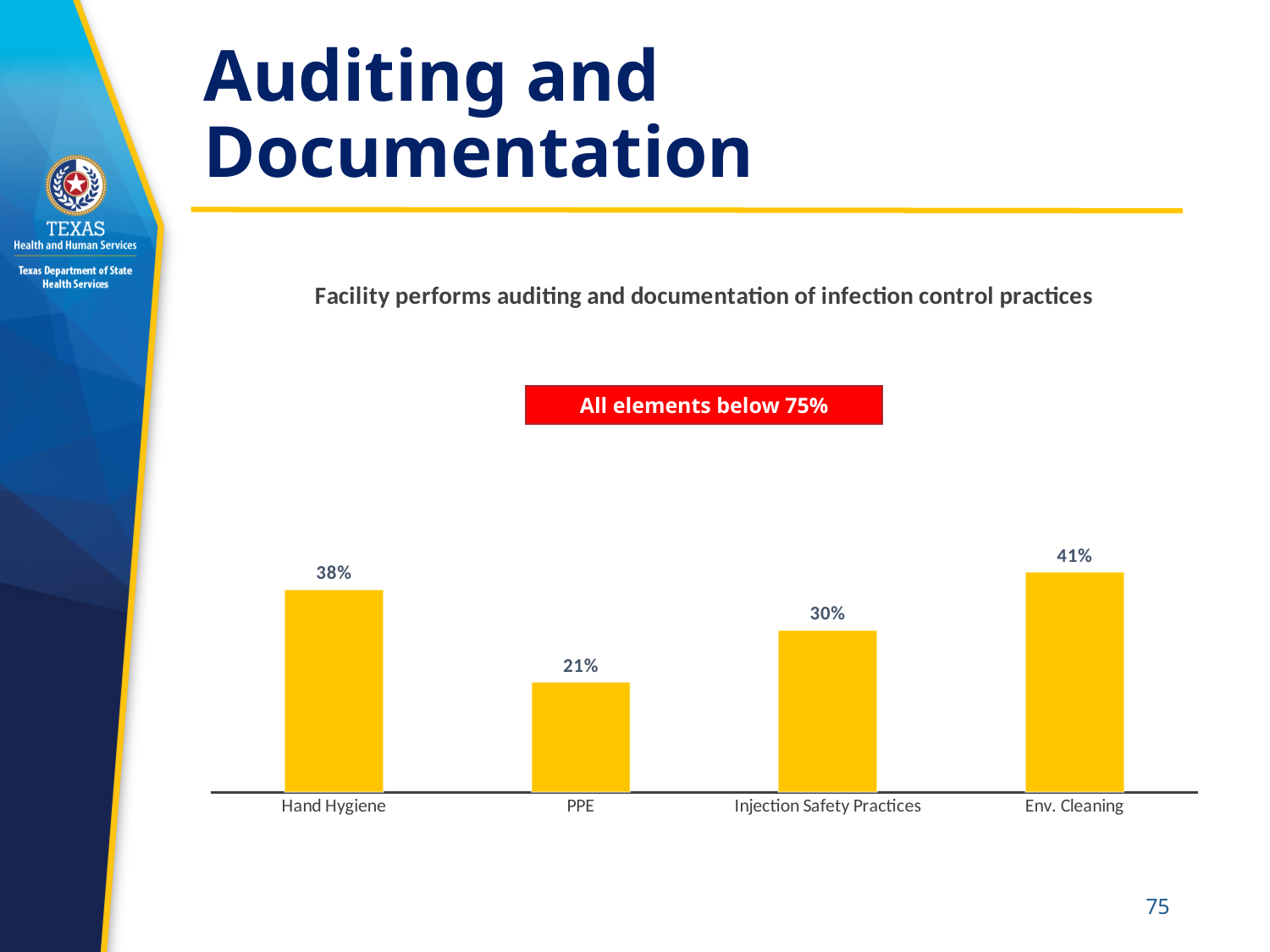
What is the difference between the values for Env. Cleaning and PPE? 20% What is the value for Env. Cleaning? 41% Which is larger, the value for Hand Hygiene or the value for Injection Safety Practices? Hand Hygiene Which category has the highest value? Env. Cleaning What is the value for Hand Hygiene? 38% What is the title of the chart? Facility performs auditing and documentation of infection control practices What kind of chart is shown on the slide? Bar chart What is the value for PPE? 21% What is the difference between the values for Hand Hygiene and Injection Safety Practices? 8% Which category has the lowest value? PPE What is the value for Injection Safety Practices? 30% How many categories are shown in the chart? 4